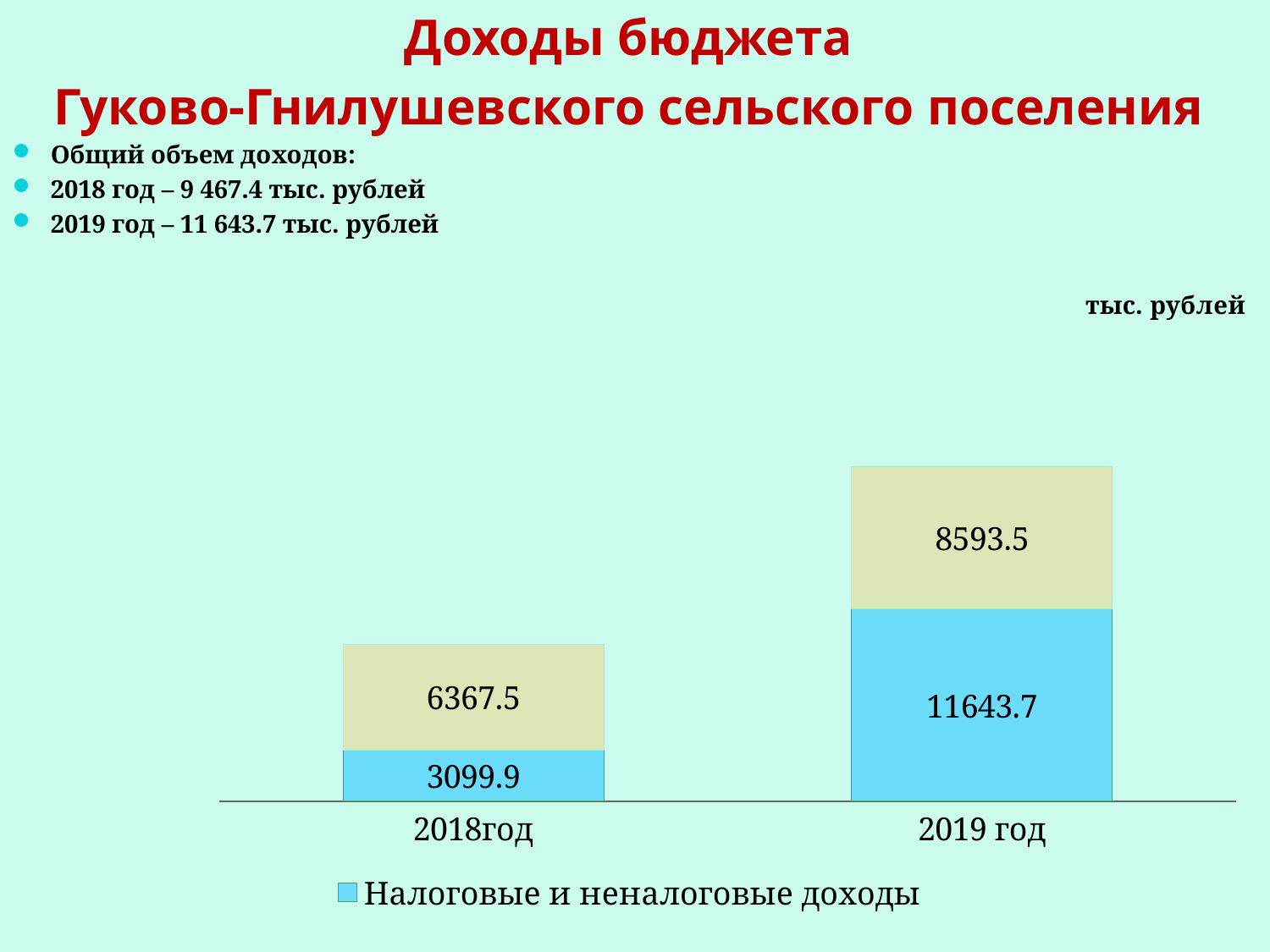
What value is printed on the upper (beige) segment of the 2019 год bar? 8593.5 What is the value of Налоговые и неналоговые доходы for 2018год? 3099.9 What is the total of the stacked bar for 2018год? 9467.4 How many series does the chart legend list? 1 What value is printed on the upper (beige) segment of the 2018год bar? 6367.5 What kind of chart is shown on the slide? bar chart What unit label is shown above the chart? тыс. рублей How many categories (years) are shown on the x axis of the chart? 2 Which year has the tallest stacked bar? 2019 год What is the value of Налоговые и неналоговые доходы for 2019 год? 11643.7 By how much does Налоговые и неналоговые доходы in 2019 год exceed that in 2018год? 8543.8 Which year has the larger value for Налоговые и неналоговые доходы, 2018год or 2019 год? 2019 год